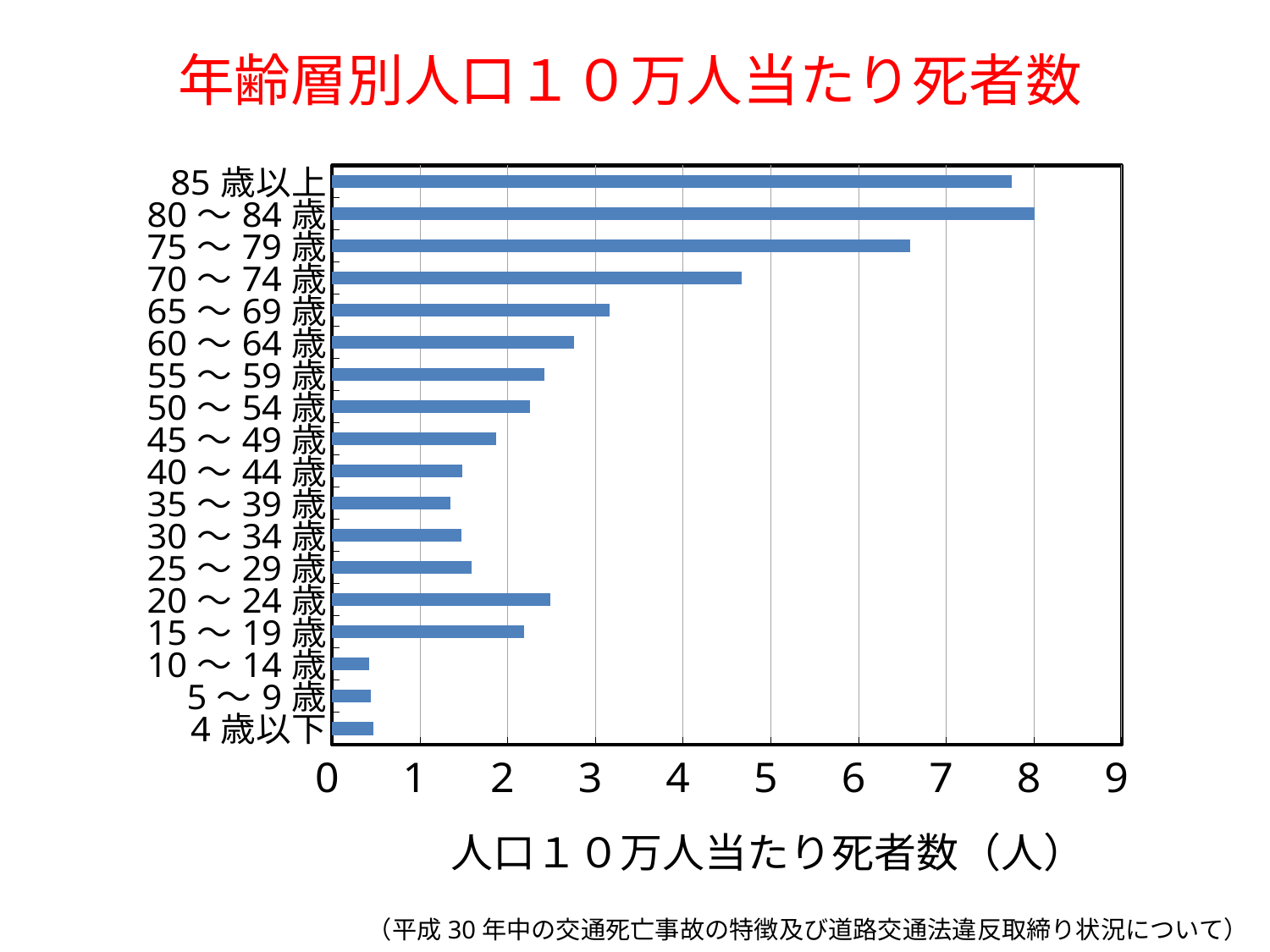
Is the value for 65～69歳 greater or less than 3? greater Is the value for 75～79歳 greater or less than 6? greater What is the title of the chart? 年齢層別人口１０万人当たり死者数 Which has a larger value, 20～24歳 or 35～39歳? 20～24歳 How many age categories are plotted in the chart? 18 Is the value for 85歳以上 greater or less than 7? greater Which has a larger value, 75～79歳 or 70～74歳? 75～79歳 Which age category has the highest value in the chart? 80～84歳 What kind of chart is shown on the slide? bar chart